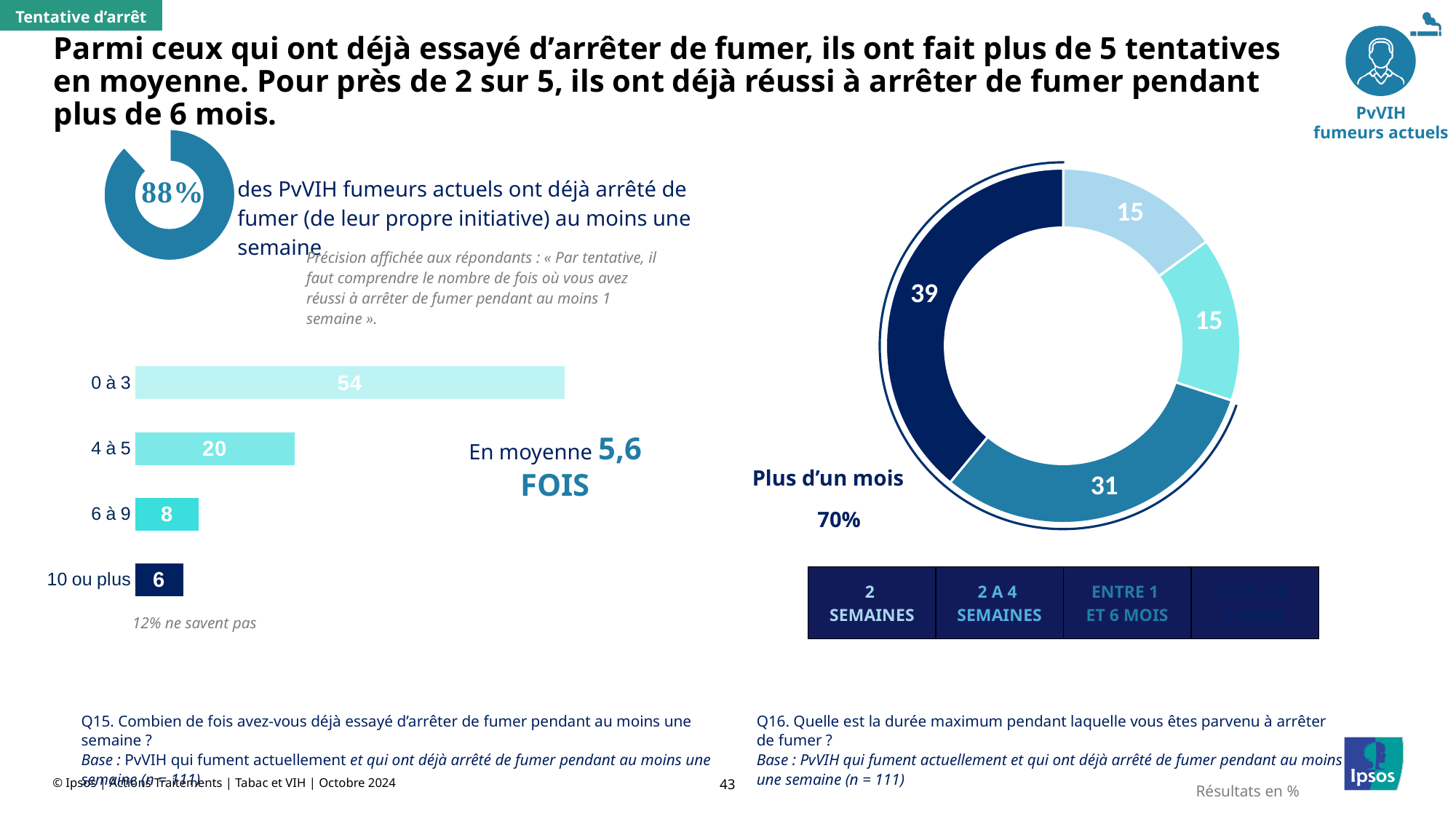
What percentage is shown in the small donut chart at the top left of the slide? 88% In the donut chart on the right, what is the value for the segment labelled '2 A 4 SEMAINES' (cyan)? 15 How many categories does the bar chart on the left show? 4 In the bar chart on the left, which category has the lowest value? 10 ou plus In the bar chart on the left, which is larger: the value for '6 à 9' or the value for '10 ou plus'? 6 à 9 In the bar chart on the left, which category has the highest value? 0 à 3 In the donut chart on the right, what is the value of the dark navy segment? 39 In the bar chart on the left, what is the value for the category '4 à 5'? 20 What type of chart is the chart on the left showing the number of quit attempts? Bar chart In the bar chart on the left, what is the value for the category '0 à 3'? 54 In the bar chart on the left, what is the value for the category '10 ou plus'? 6 In the bar chart on the left, what is the difference between the values for '0 à 3' and '4 à 5'? 34